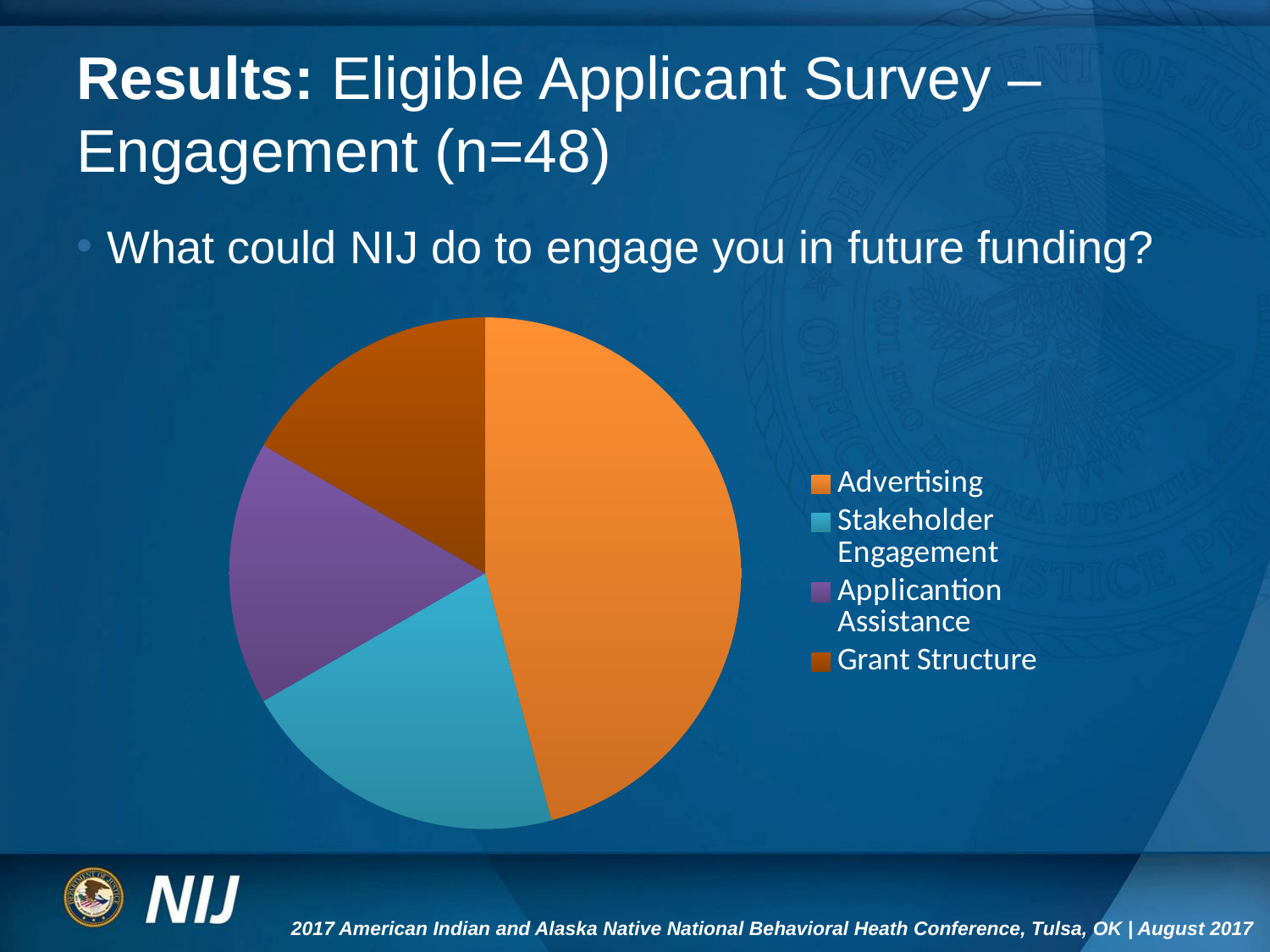
Which category is listed last in the pie chart's legend? Grant Structure How many slices does the pie chart have? 4 Which category has the largest slice of the pie chart? Advertising Which category is shown in purple in the pie chart? Applicantion Assistance Which is larger in the pie chart, Advertising or Stakeholder Engagement? Advertising What kind of chart is shown on the slide? Pie chart Which is larger in the pie chart, Advertising or Grant Structure? Advertising Which is larger in the pie chart, Applicantion Assistance or Advertising? Advertising How many entries does the legend of the pie chart list? 4